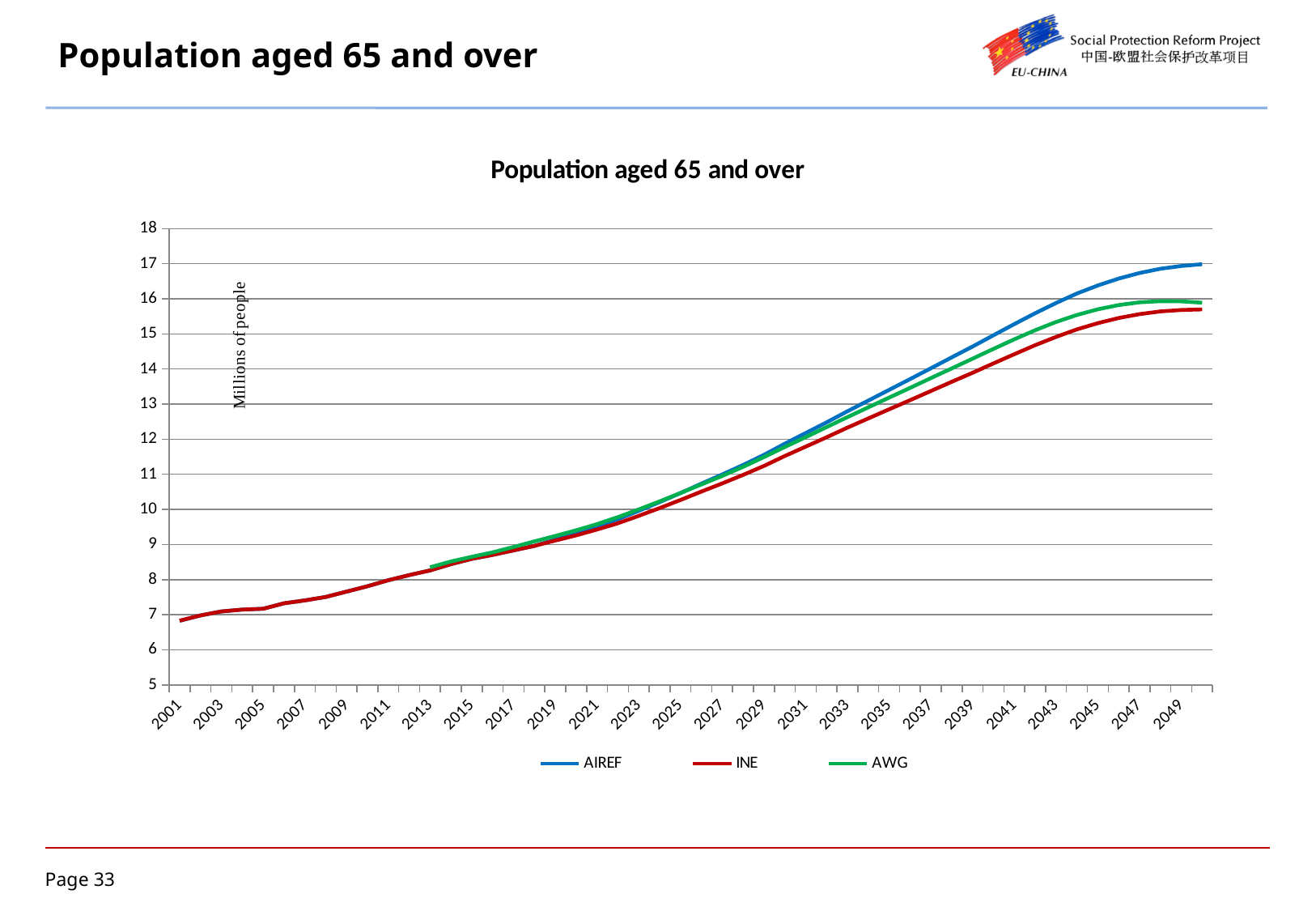
Which series has the highest value in 2049? AIREF Do the values for the INE series rise or fall from 2001 to 2049? rise Is the value for INE in 2049 greater or less than 16? less How many series does the legend list? 3 What is the label on the vertical axis? Millions of people In 2049, which is larger, the value for AIREF or the value for INE? AIREF Is the value for AIREF in 2041 greater or less than 14? greater What are the names of the series in the legend? AIREF, INE, AWG Which series has the lowest value in 2049? INE What kind of chart is shown on the slide? line chart How many year labels are shown on the x axis? 25 Is the value for AIREF in 2049 greater or less than 16? greater